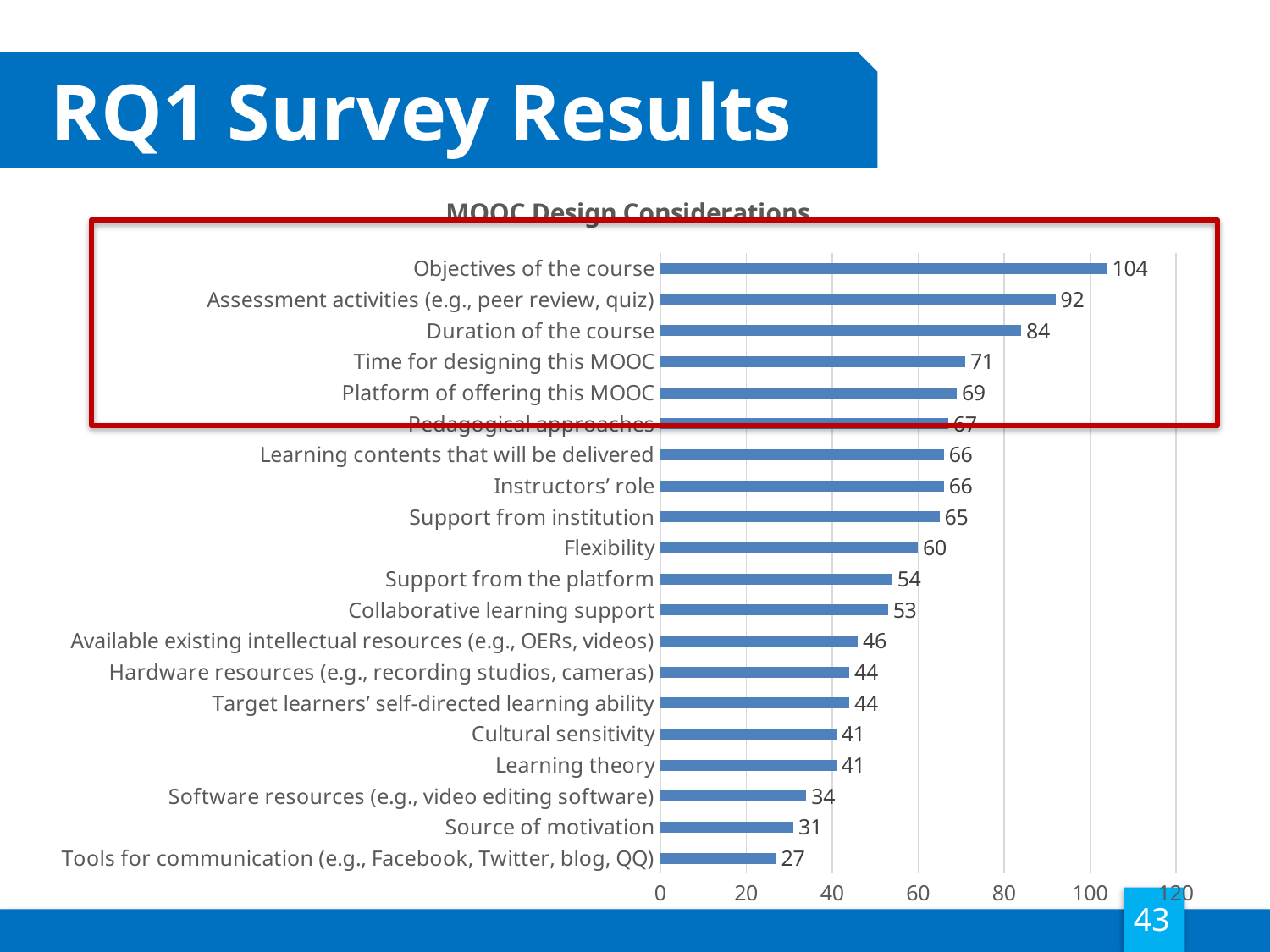
What is the value for Flexibility? 60 Which category has the highest value? Objectives of the course Is the value for Time for designing this MOOC greater or less than 60? greater What is the value for Duration of the course? 84 What kind of chart is shown on the slide? Bar chart Which category has the lowest value? Tools for communication (e.g., Facebook, Twitter, blog, QQ) What is the difference between the values for Objectives of the course and Assessment activities (e.g., peer review, quiz)? 12 What is the value for Source of motivation? 31 How many categories are shown in the chart? 20 Which is larger, the value for Support from the platform or the value for Cultural sensitivity? Support from the platform What is the title of the chart? MOOC Design Considerations What is the value for Objectives of the course? 104